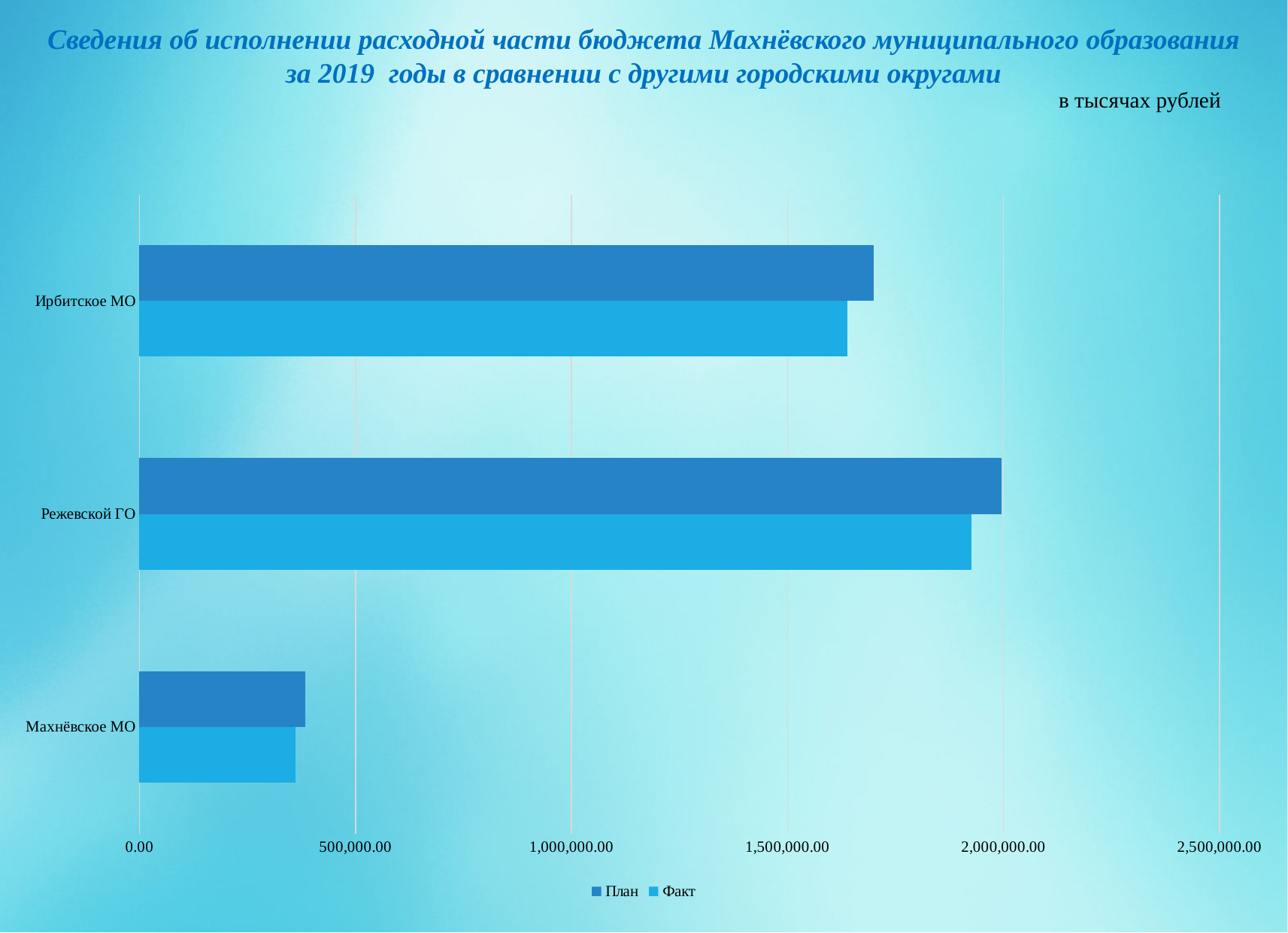
What are the two series named in the legend? План and Факт Is the Факт value for Режевской ГО greater or less than 1,500,000.00? greater Is the План value for Махнёвское МО greater or less than 500,000.00? less Which municipality has the lowest Факт value? Махнёвское МО Is the Факт value for Махнёвское МО greater or less than 500,000.00? less Which municipality has the highest План value? Режевской ГО Which municipality has a larger Факт value: Ирбитское МО or Махнёвское МО? Ирбитское МО What kind of chart is shown on the slide? bar chart How many series does the legend list? 2 Which is larger for Режевской ГО: the План value or the Факт value? План How many municipalities (categories) are shown on the chart? 3